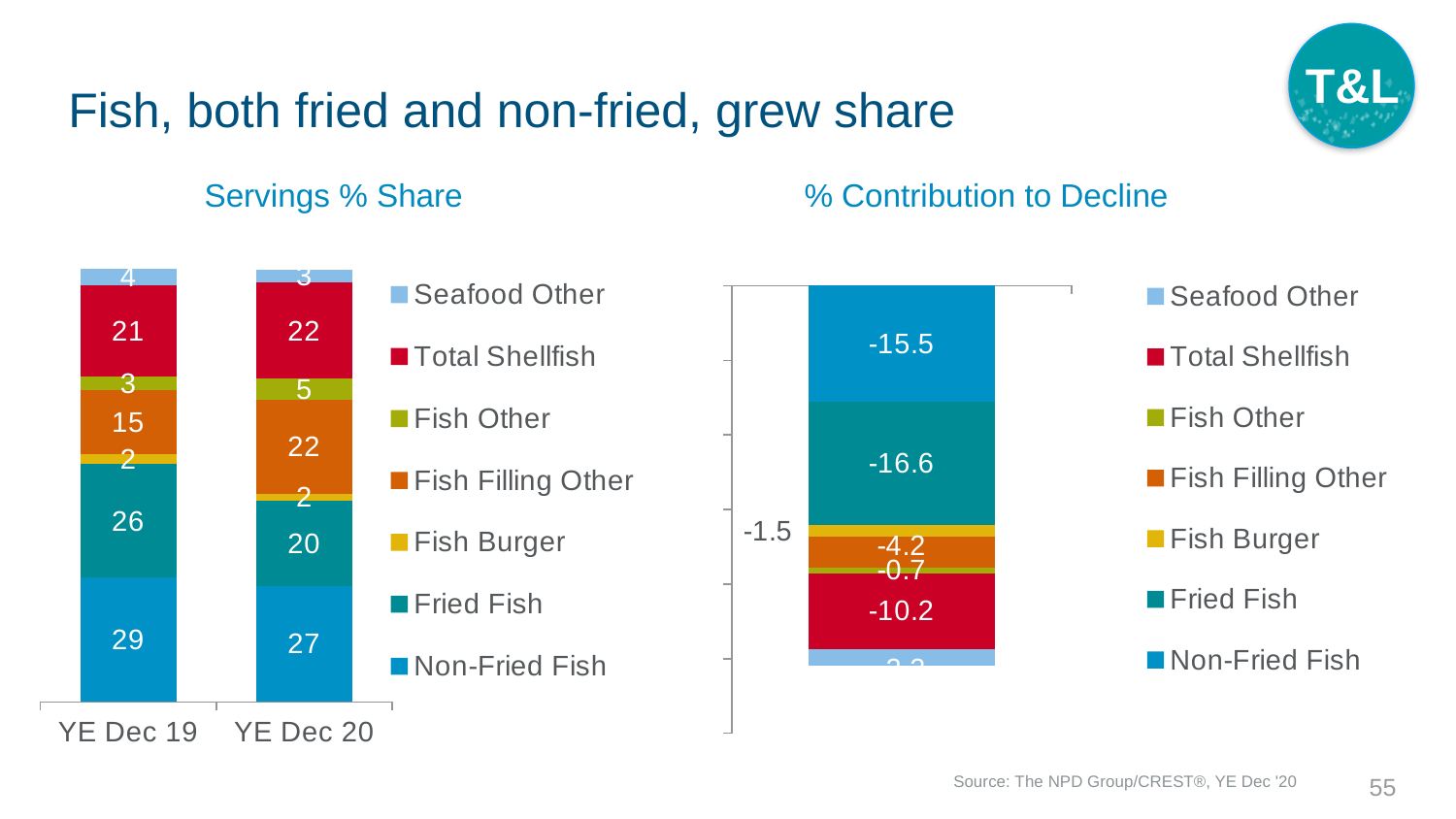
In the Servings % Share chart, what is the value for Fish Filling Other in YE Dec 20? 22 How many series does the legend of the Servings % Share chart list? 7 In the Servings % Share chart, by how much did the Fried Fish value fall from YE Dec 19 to YE Dec 20? 6 In the Servings % Share chart, what is the value for Non-Fried Fish in YE Dec 19? 29 In the % Contribution to Decline chart, what is the value for Fried Fish? -16.6 In the % Contribution to Decline chart, what is the value for Total Shellfish? -10.2 What kind of chart is the Servings % Share chart? Stacked bar chart In the Servings % Share chart, is the Fish Other value larger in YE Dec 19 or YE Dec 20? YE Dec 20 In the Servings % Share chart, what is the total of the YE Dec 19 stacked bar? 100 In the Servings % Share chart, what is the value for Fried Fish in YE Dec 20? 20 In the % Contribution to Decline chart, which series has the largest contribution to the decline? Fried Fish How many categories are shown on the x axis of the Servings % Share chart? 2